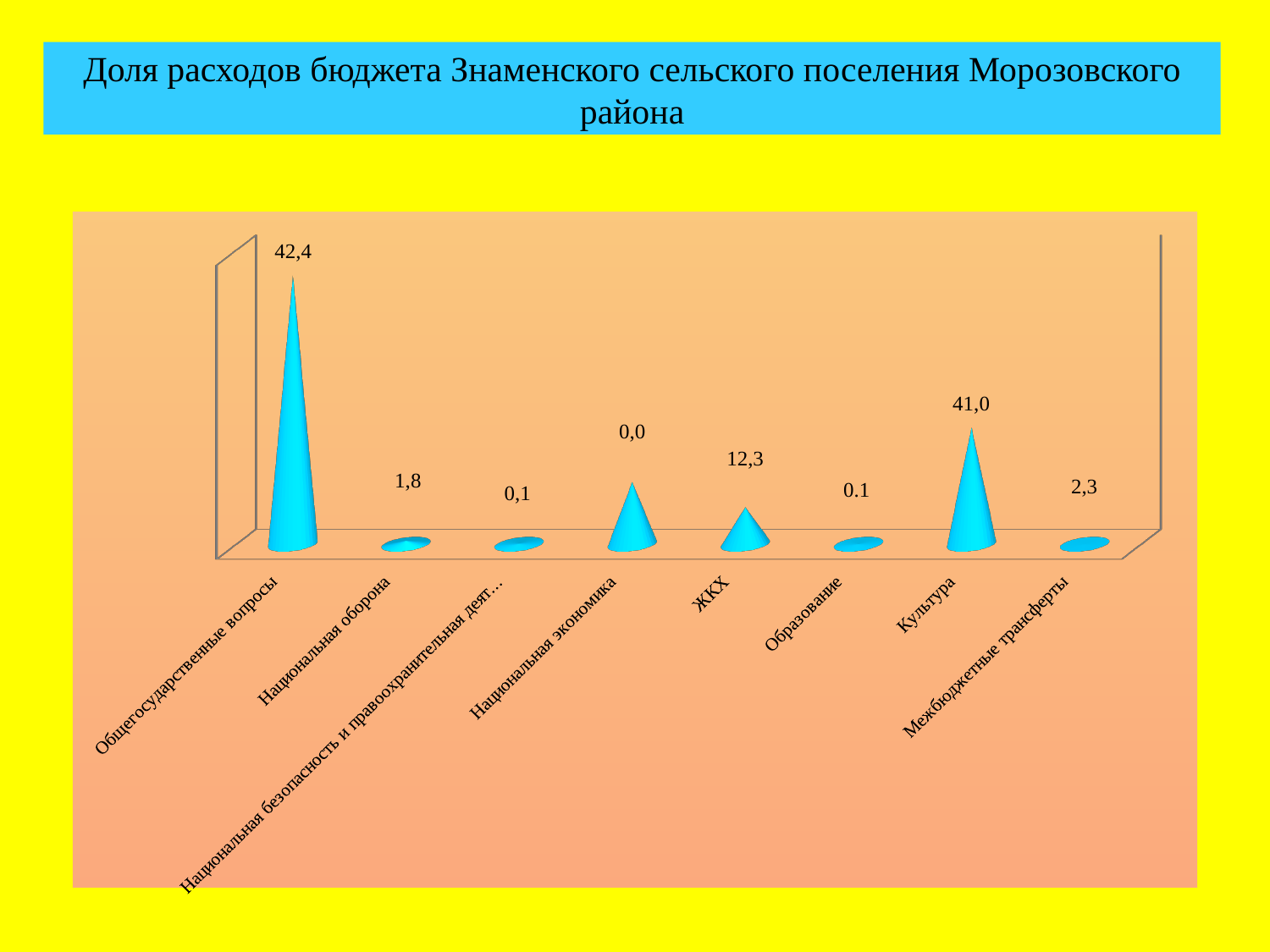
What kind of chart is shown on the slide? Bar chart What is the value for Культура? 41,0 What is the difference between the values for Общегосударственные вопросы and Культура? 1,4 What is the difference between the values for Культура and ЖКХ? 28,7 Which is larger, the value for Межбюджетные трансферты or the value for Национальная оборона? Межбюджетные трансферты What is the value for Национальная оборона? 1,8 How many categories are shown on the chart? 8 What is the value for Межбюджетные трансферты? 2,3 What is the value for Общегосударственные вопросы? 42,4 Which category has the highest value? Общегосударственные вопросы What is the value for ЖКХ? 12,3 Which is larger, the value for Культура or the value for ЖКХ? Культура